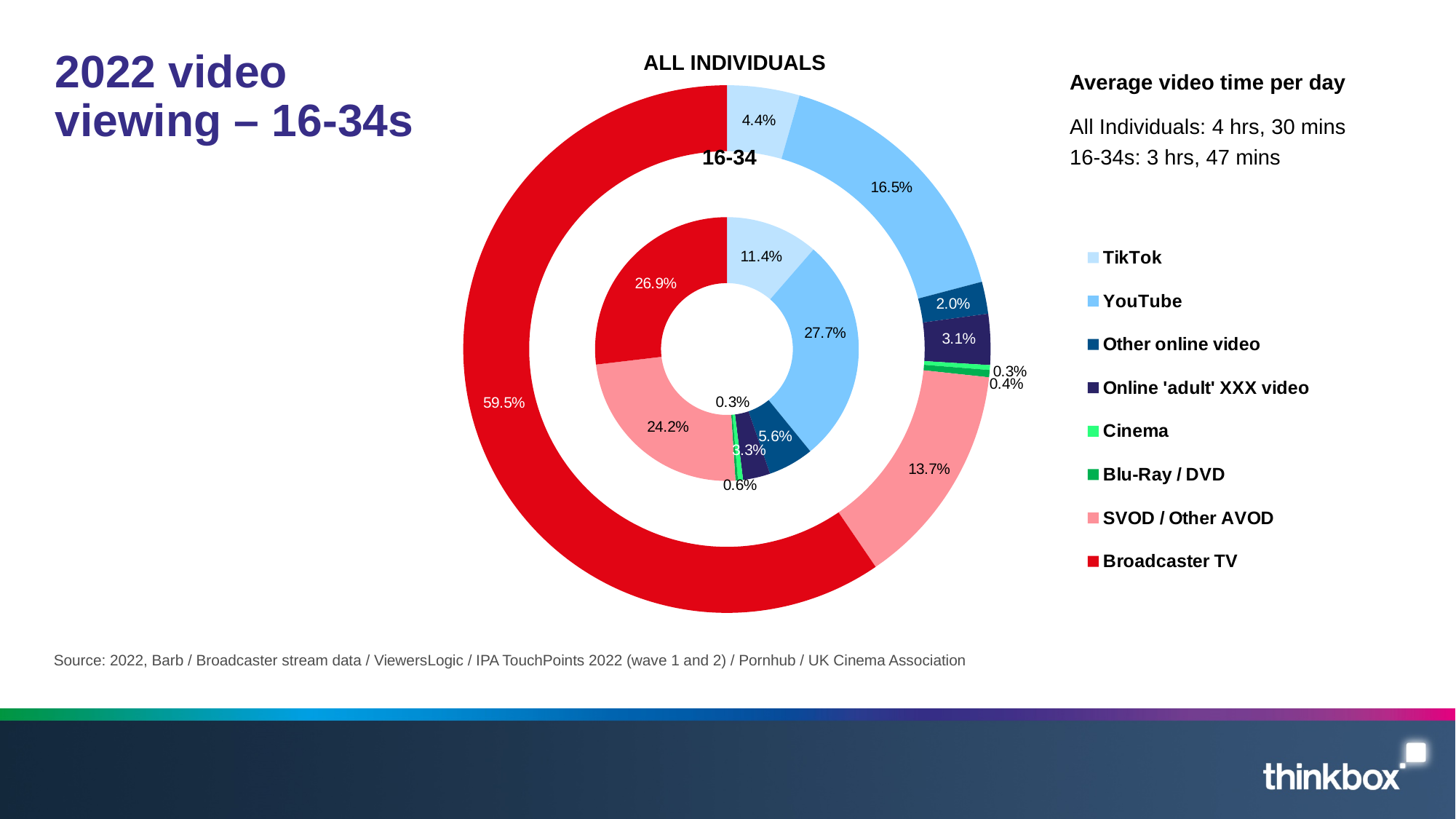
What type of chart is shown on the slide? Doughnut chart What is the difference between the TikTok share for 16-34s (inner ring) and for All Individuals (outer ring)? 7.0 percentage points How many series does the legend list? 8 According to the text on the slide, what is the average video time per day for 16-34s? 3 hrs, 47 mins Which category has the smallest share in the outer ring (All Individuals)? Cinema In the inner ring (16-34), what share of video viewing is YouTube? 27.7% What is the difference between the Broadcaster TV share for All Individuals (outer ring) and for 16-34s (inner ring)? 32.6 percentage points Which category has the largest share in the inner ring (16-34)? YouTube In the outer ring (All Individuals), what share of video viewing is SVOD / Other AVOD? 13.7% In the outer ring (All Individuals), what share of video viewing is Broadcaster TV? 59.5% Which is larger for 16-34s (inner ring): the SVOD / Other AVOD share or the Broadcaster TV share? Broadcaster TV In the inner ring (16-34), what share of video viewing is TikTok? 11.4%